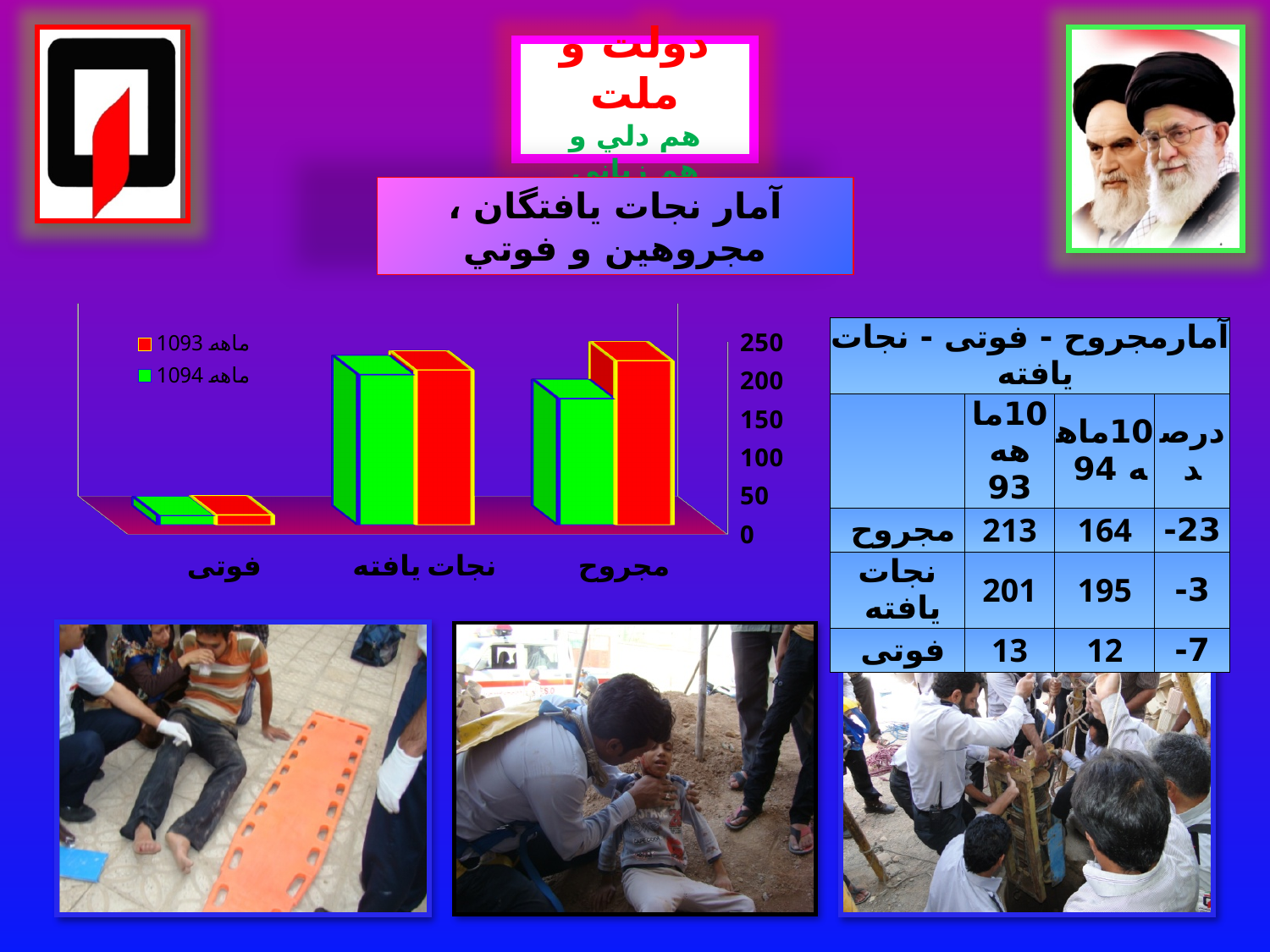
Which category has the tallest bar in the chart? مجروح Is the green bar for مجروح greater or less than 200? less How many series does the legend of the bar chart list? 2 What kind of chart is shown on the slide? bar chart How many categories are shown on the x axis of the bar chart? 3 Is the red bar for مجروح greater or less than 200? greater Which category has larger bars, نجات یافته or فوتی? نجات یافته Are the bars for فوتی greater or less than 50? less For مجروح, which series has the larger bar, the red one or the green one? red Which category has the shortest bars in the chart? فوتی Which colour represents the series labelled 1094 ماهه in the legend? green